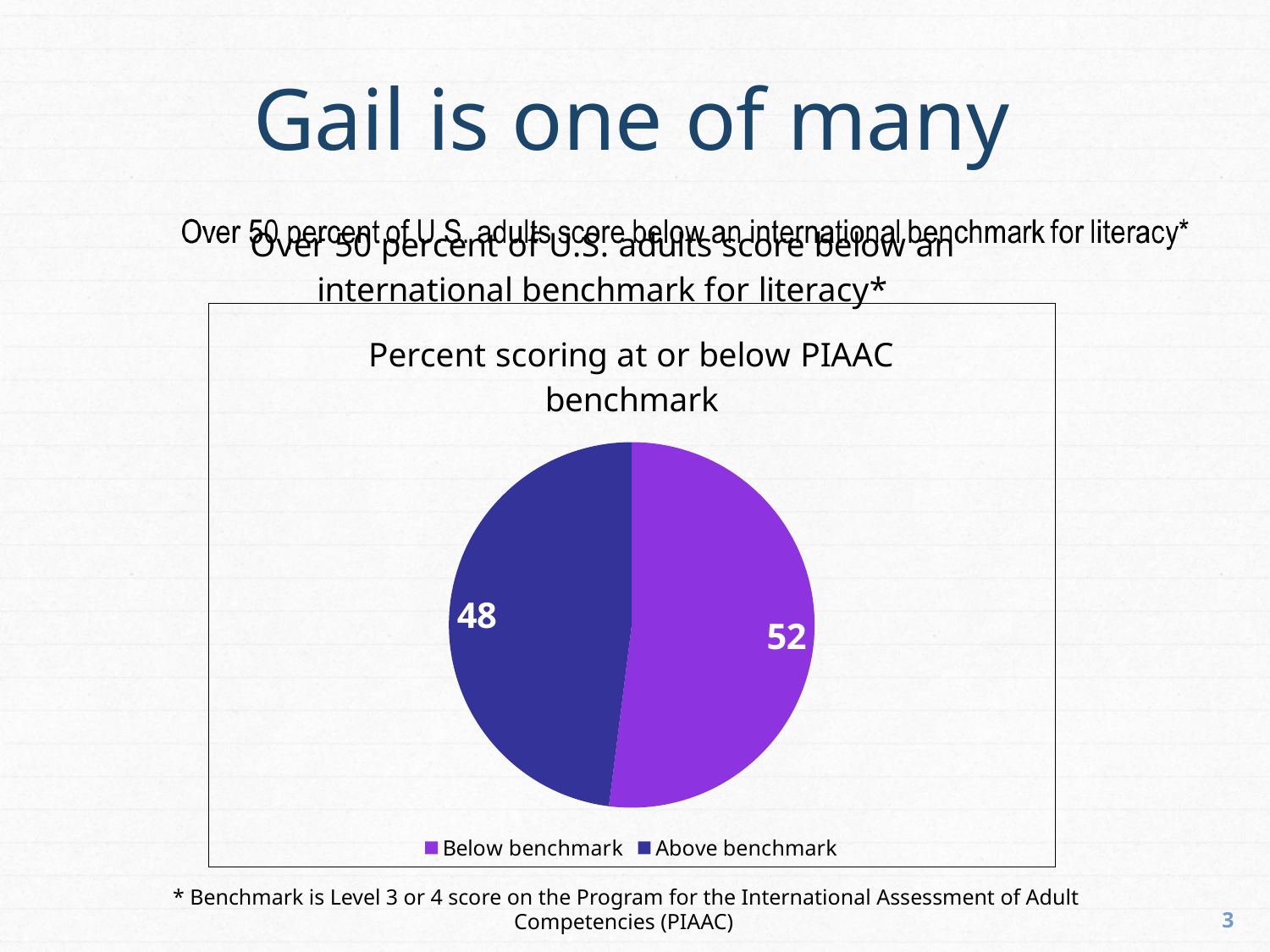
What is the title of the chart? Percent scoring at or below PIAAC benchmark Is the value for Below benchmark larger or smaller than the value for Above benchmark? larger Which category has the larger value? Below benchmark What share of the pie does the Below benchmark slice represent? 52% Which legend entry is shown in the darker blue-purple colour? Above benchmark What is the difference between the Below benchmark and Above benchmark values? 4 What type of chart is shown on the slide? pie chart How many entries does the legend list? 2 What is the value for Above benchmark? 48 Which category has the smaller value? Above benchmark What is the value for Below benchmark? 52 How many slices does the pie chart have? 2